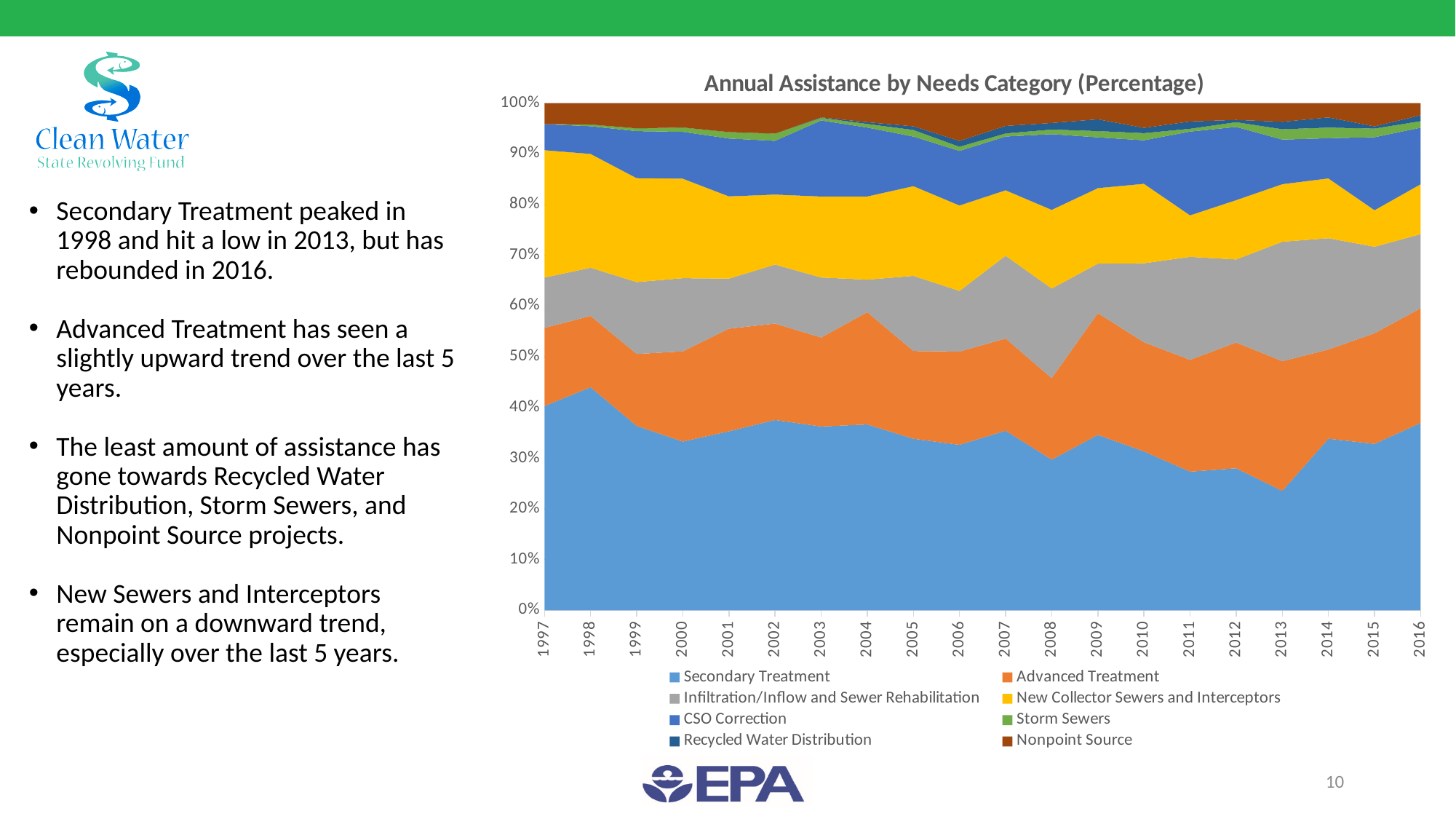
What is the title of the chart? Annual Assistance by Needs Category (Percentage) Is the Secondary Treatment share in 1998 greater or less than 40%? greater Is the Secondary Treatment share in 2013 greater or less than 30%? less What kind of chart is shown on the slide? Stacked area chart In which year does the Secondary Treatment share reach its highest value? 1998 Which series is plotted at the bottom of the stacked areas in the chart? Secondary Treatment What is the first year shown on the x axis of the chart? 1997 What is the last year shown on the x axis of the chart? 2016 How many years are plotted along the x axis of the chart? 20 How many series does the chart's legend list? 8 In which year does the Secondary Treatment share reach its lowest value? 2013 Which is larger, the Secondary Treatment share in 1998 or in 2013? 1998